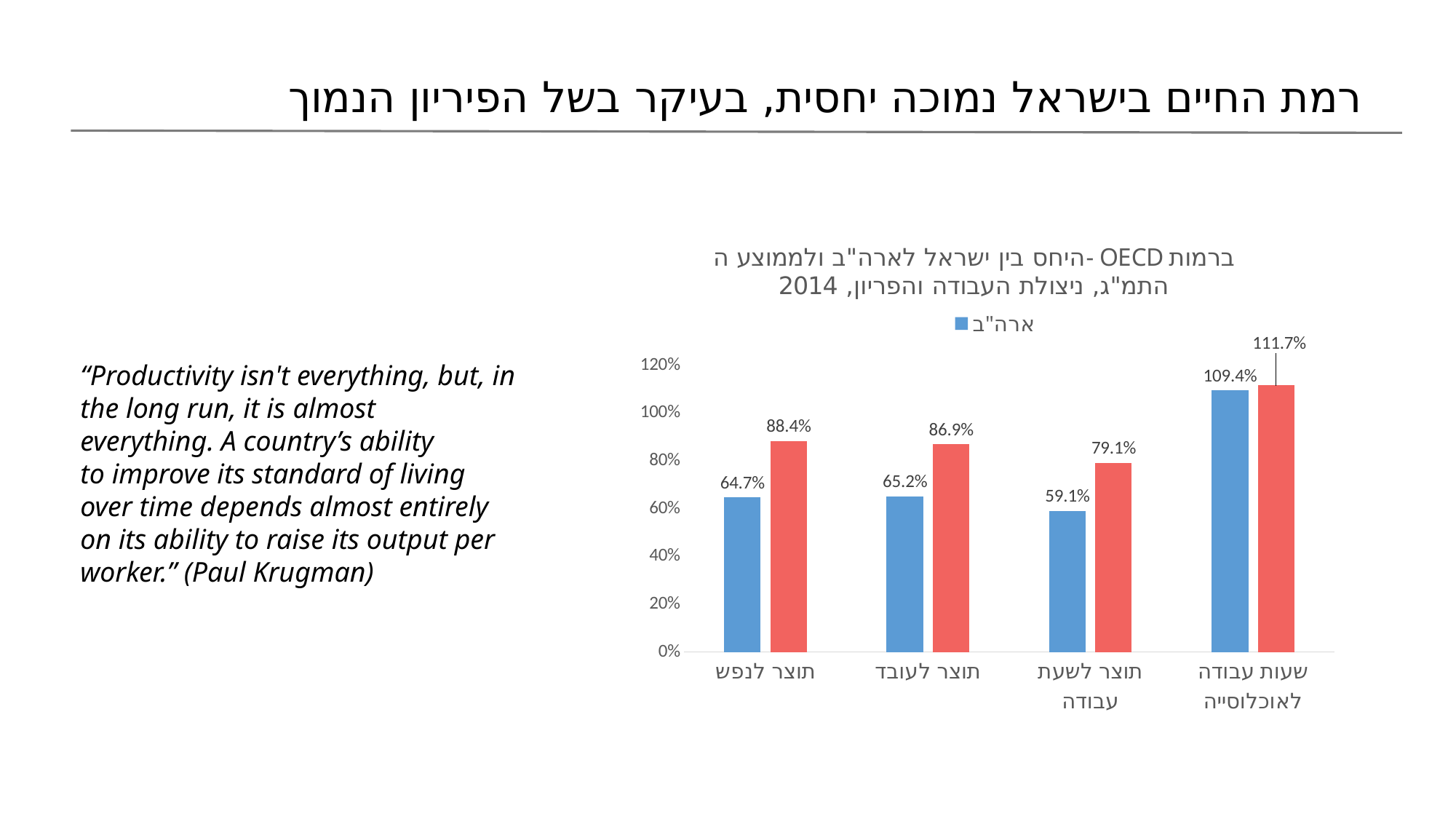
What is the value of the blue (ארה"ב) bar for תוצר לנפש? 64.7% Which is larger for תוצר לעובד: the blue (ארה"ב) bar or the red bar? the red bar Is the value of the blue (ארה"ב) bar for שעות עבודה לאוכלוסייה greater or less than 100%? greater What is the value of the red bar for תוצר לשעת עבודה? 79.1% What is the value of the blue (ארה"ב) bar for תוצר לעובד? 65.2% Which category has the highest value for the red series? שעות עבודה לאוכלוסייה What type of chart is shown on the slide? bar chart Which category has the lowest value for the blue (ארה"ב) series? תוצר לשעת עבודה What is the difference between the red bar and the blue bar for שעות עבודה לאוכלוסייה? 2.3% What is the value of the red bar for שעות עבודה לאוכלוסייה? 111.7% How many categories are shown on the x axis of the chart? 4 What is the difference between the red bar and the blue bar for תוצר לנפש? 23.7%